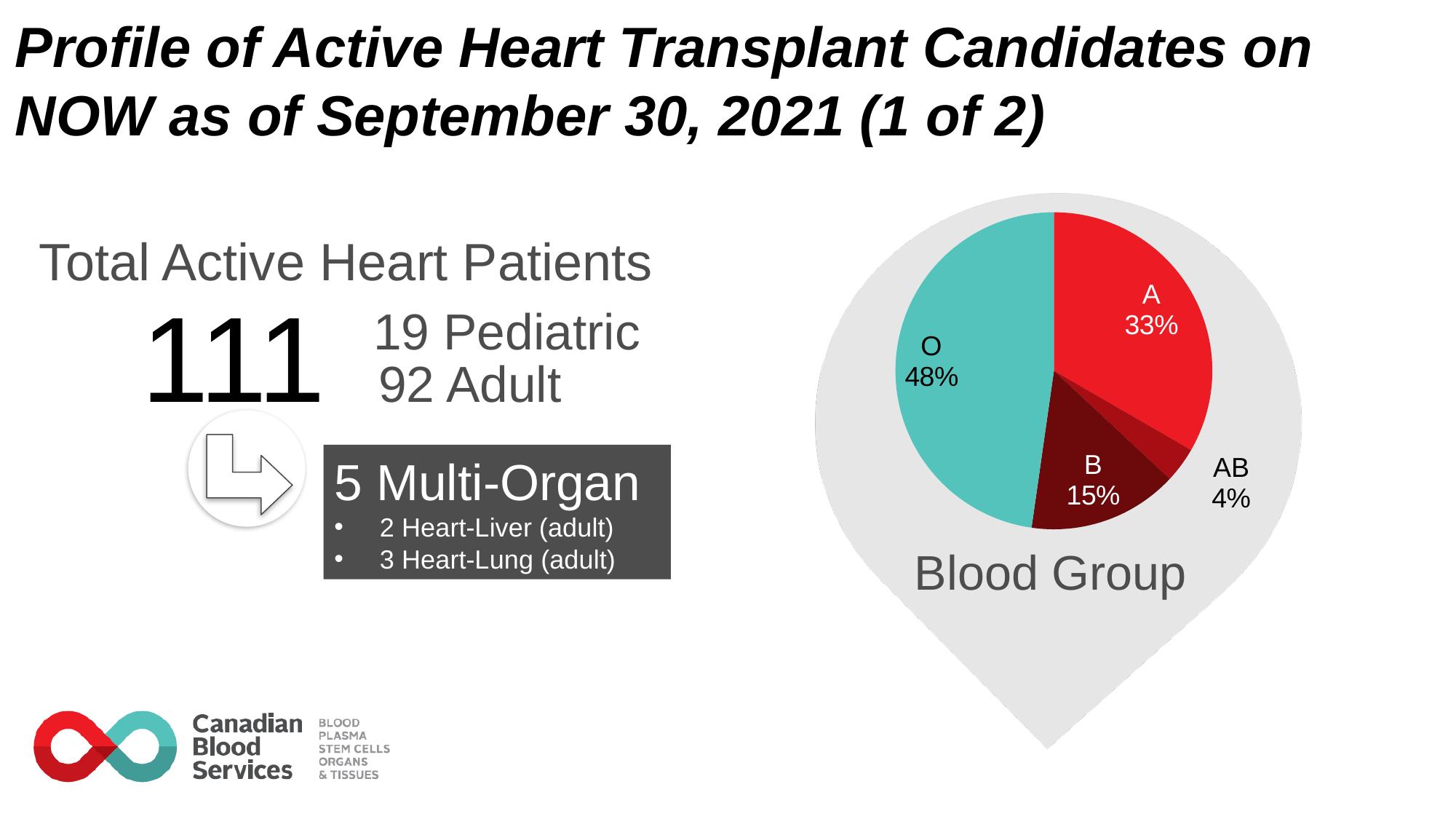
What type of chart is used to show the blood group distribution? pie chart Which blood group has the smallest slice in the Blood Group pie chart? AB What colour is the slice for blood group O in the pie chart? teal What is the difference in percentage points between blood group B and blood group AB in the pie chart? 11 How many blood group categories are shown in the pie chart? 4 Which is larger in the Blood Group pie chart, blood group B or blood group AB? B What share of the Blood Group pie chart is blood group AB? 4% What share of the Blood Group pie chart is blood group A? 33% What is the difference in percentage points between blood group O and blood group A in the pie chart? 15 What share of the Blood Group pie chart is blood group B? 15% Which blood group has the largest slice in the Blood Group pie chart? O